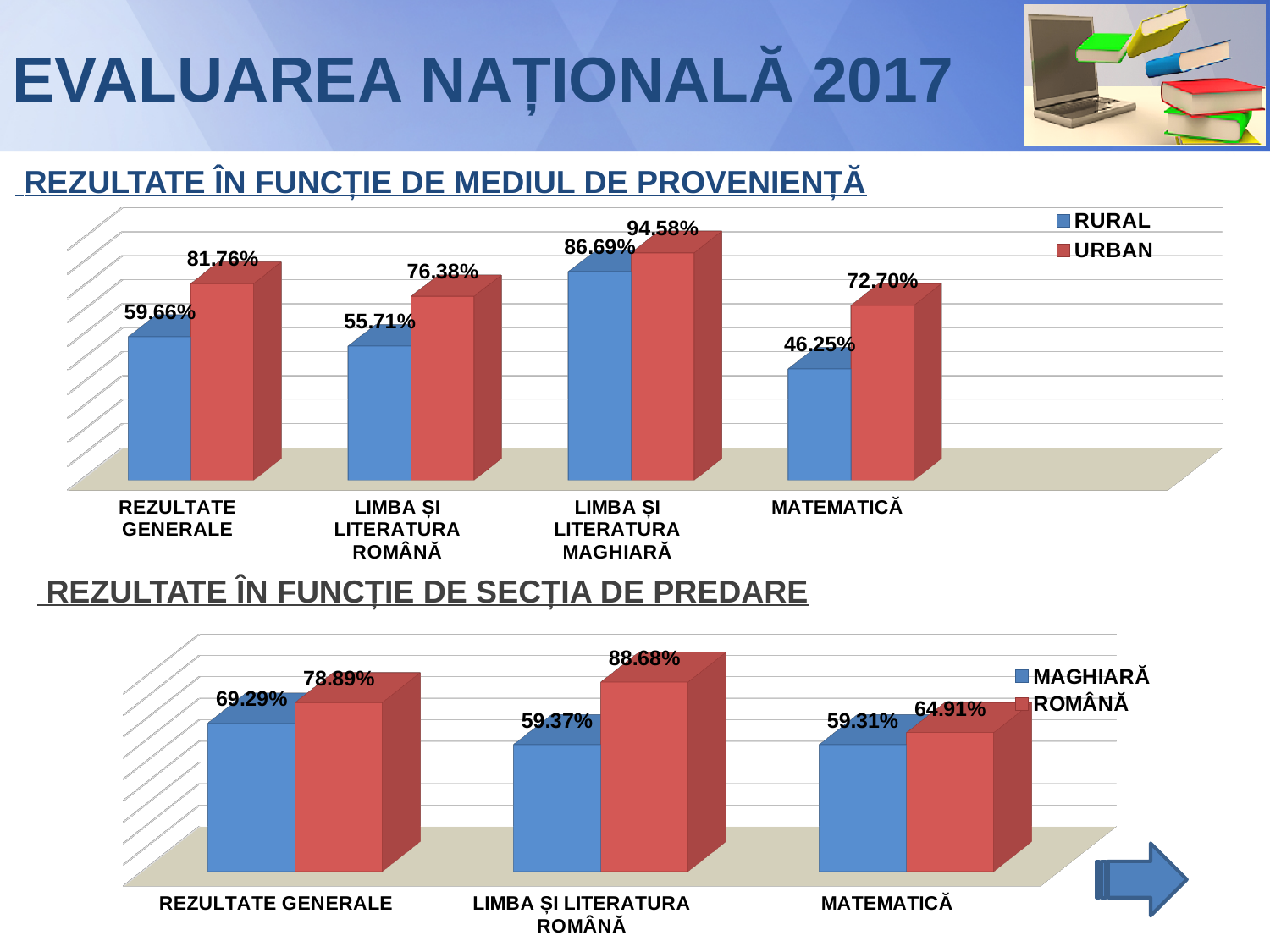
In the bottom chart (REZULTATE ÎN FUNCȚIE DE SECȚIA DE PREDARE), which is larger for REZULTATE GENERALE: MAGHIARĂ or ROMÂNĂ? ROMÂNĂ In the bottom chart (REZULTATE ÎN FUNCȚIE DE SECȚIA DE PREDARE), what is the MAGHIARĂ value for MATEMATICĂ? 59.31% In the bottom chart (REZULTATE ÎN FUNCȚIE DE SECȚIA DE PREDARE), what is the difference between the ROMÂNĂ and MAGHIARĂ values for LIMBA ȘI LITERATURA ROMÂNĂ? 29.31% In the top chart (REZULTATE ÎN FUNCȚIE DE MEDIUL DE PROVENIENȚĂ), what is the difference between the URBAN and RURAL values for REZULTATE GENERALE? 22.10% What kind of chart is the bottom chart (REZULTATE ÎN FUNCȚIE DE SECȚIA DE PREDARE)? Bar chart In the top chart (REZULTATE ÎN FUNCȚIE DE MEDIUL DE PROVENIENȚĂ), how many series does the legend list? 2 In the top chart (REZULTATE ÎN FUNCȚIE DE MEDIUL DE PROVENIENȚĂ), which category has the lowest RURAL value? MATEMATICĂ In the top chart (REZULTATE ÎN FUNCȚIE DE MEDIUL DE PROVENIENȚĂ), what is the RURAL value for MATEMATICĂ? 46.25% In the top chart (REZULTATE ÎN FUNCȚIE DE MEDIUL DE PROVENIENȚĂ), how many categories are shown on the x axis? 4 In the top chart (REZULTATE ÎN FUNCȚIE DE MEDIUL DE PROVENIENȚĂ), what is the URBAN value for LIMBA ȘI LITERATURA MAGHIARĂ? 94.58% In the bottom chart (REZULTATE ÎN FUNCȚIE DE SECȚIA DE PREDARE), what is the ROMÂNĂ value for LIMBA ȘI LITERATURA ROMÂNĂ? 88.68% In the top chart (REZULTATE ÎN FUNCȚIE DE MEDIUL DE PROVENIENȚĂ), which category has the highest URBAN value? LIMBA ȘI LITERATURA MAGHIARĂ